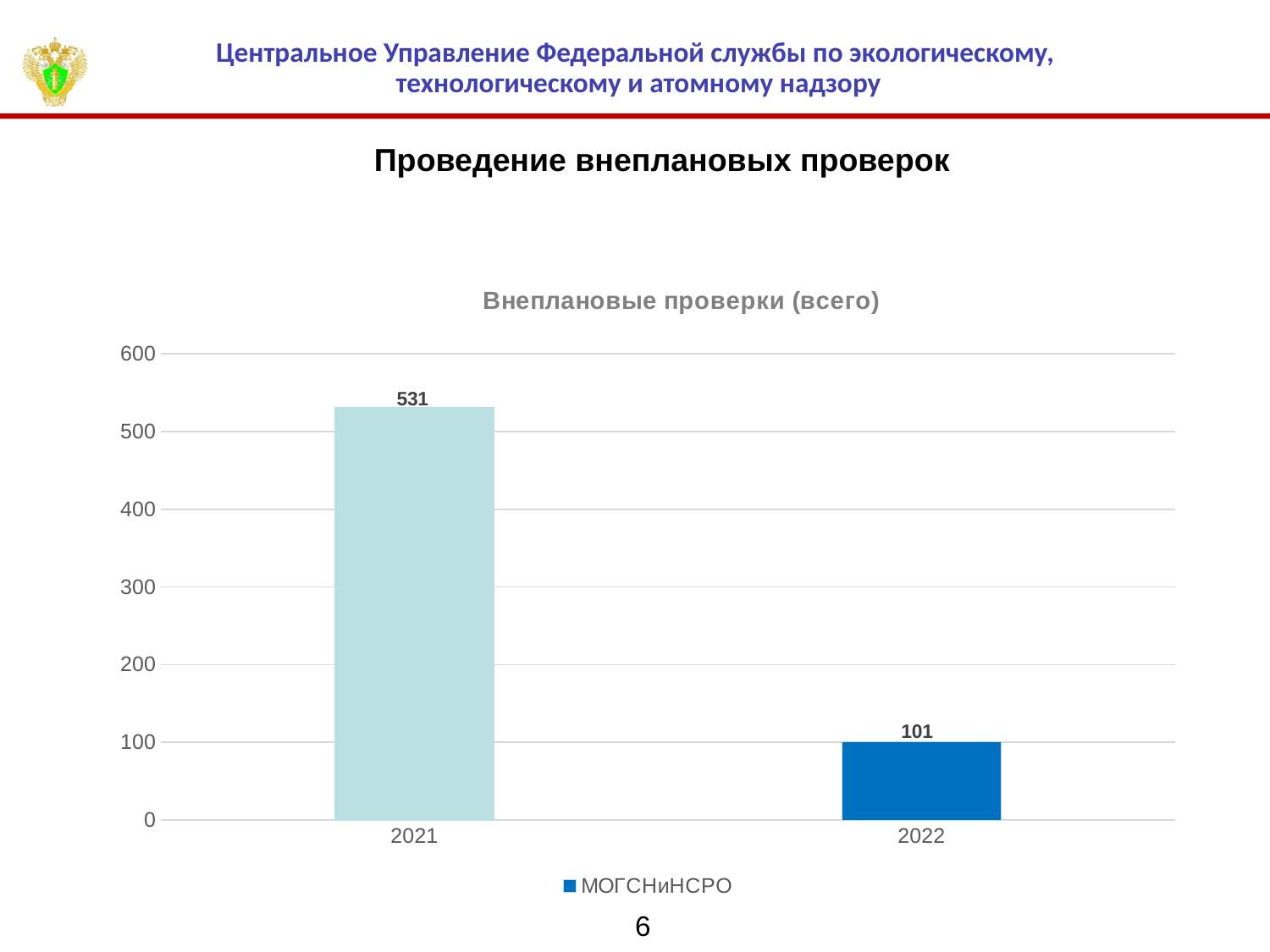
What is the value for 2022? 101 What kind of chart is this? bar chart Is the value for 2021 greater or less than 500? greater Which year has the lowest value? 2022 Which year has the highest value? 2021 How many series does the legend list? 1 Is the value for 2022 greater or less than 200? less What is the difference between the values for 2021 and 2022? 430 Which is larger, the value for 2021 or the value for 2022? 2021 What is the title of the chart? Внеплановые проверки (всего) What is the value for 2021? 531 How many categories are shown on the x axis? 2